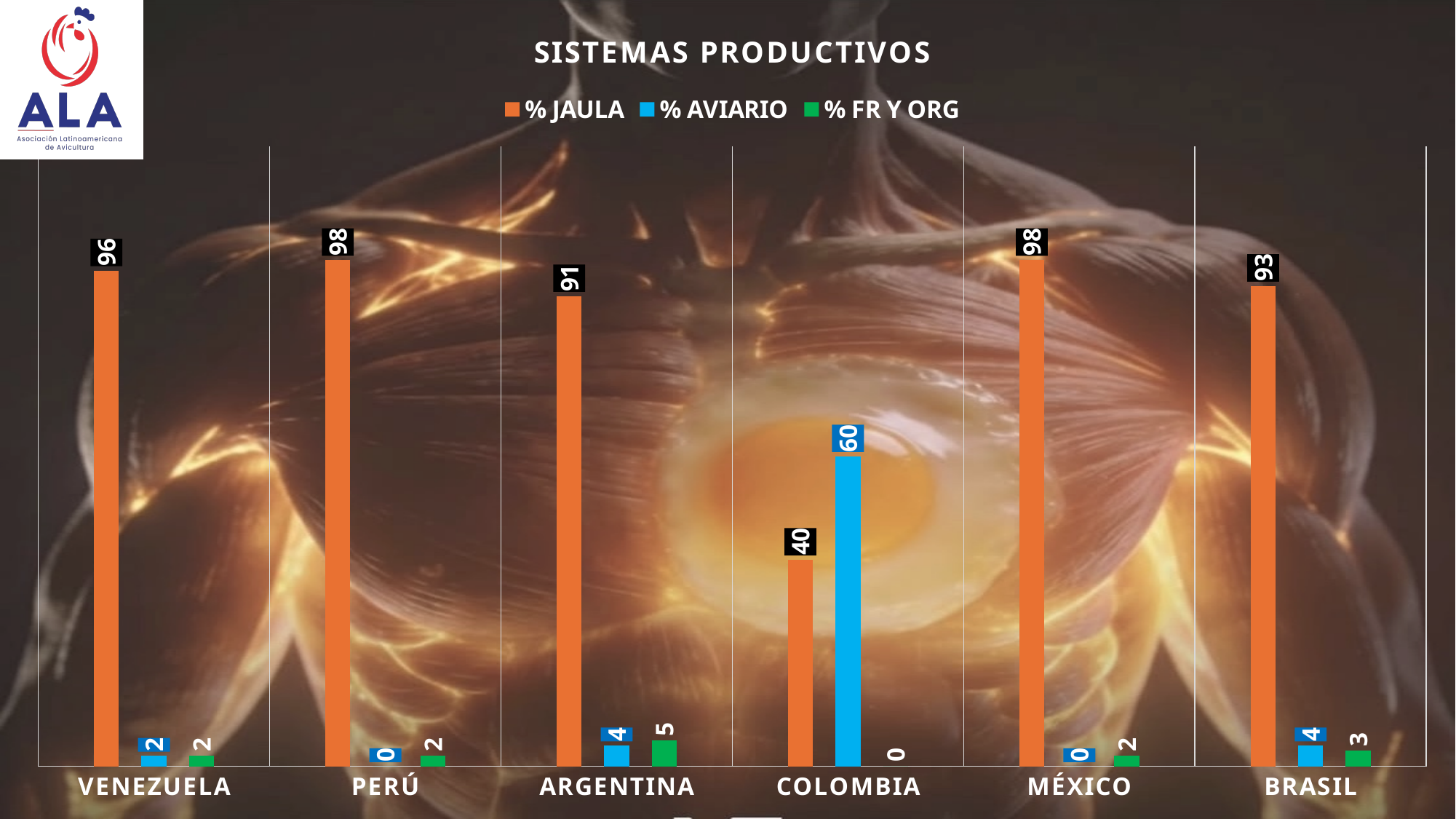
Which country has the lowest % JAULA value? Colombia How many series does the legend list? 3 What is the % AVIARIO value for Colombia? 60 Which is larger, the % JAULA value for Argentina or for Brasil? Brasil What is the difference between the % AVIARIO and % JAULA values for Colombia? 20 Which country has the highest % AVIARIO value? Colombia What is the % FR Y ORG value for Argentina? 5 How many countries are shown on the x axis? 6 What type of chart is shown on the slide? Bar chart What is the % JAULA value for Brasil? 93 Which country has the highest % FR Y ORG value? Argentina What is the % JAULA value for Venezuela? 96